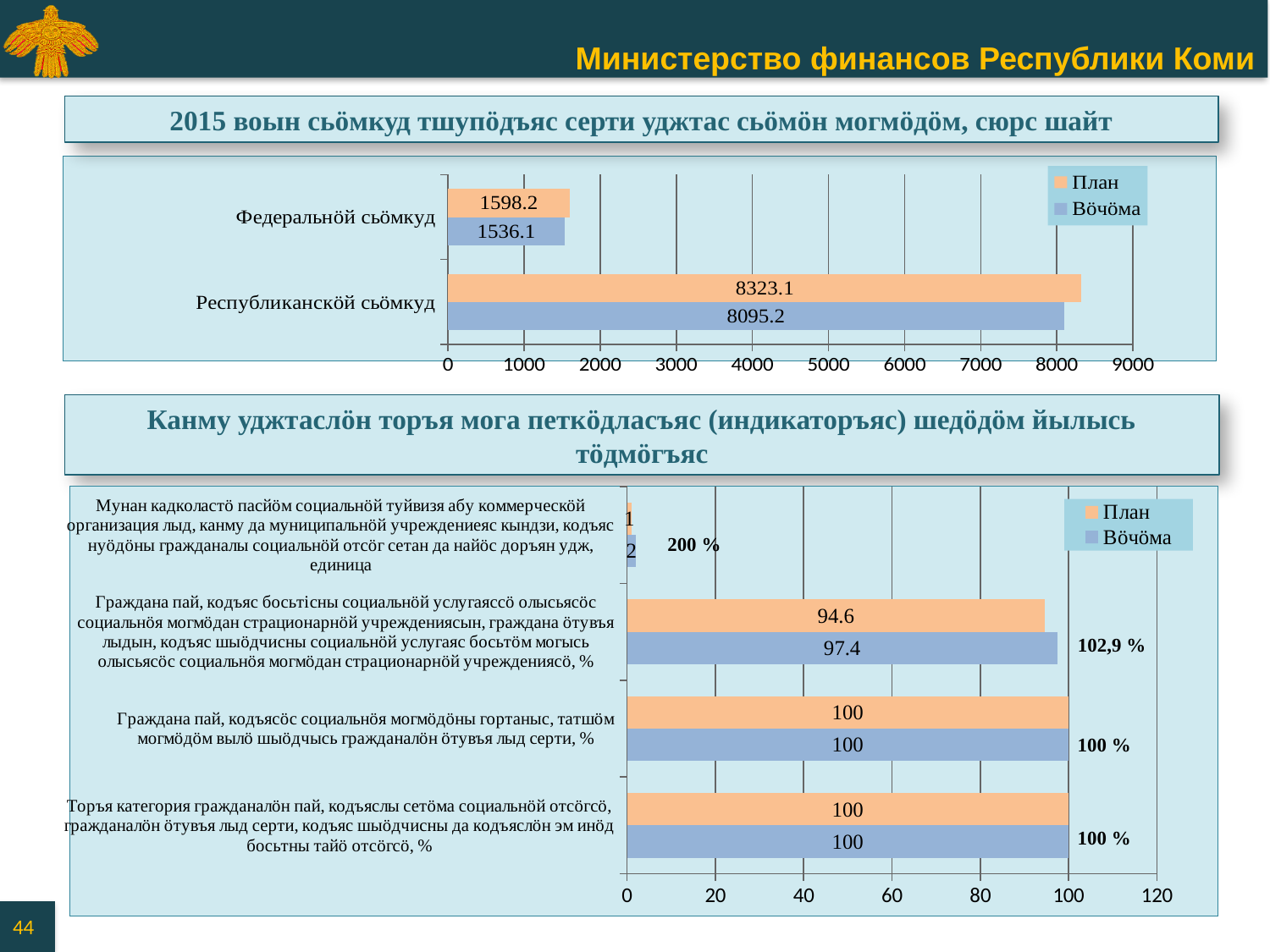
In the bottom chart, what percentage is printed next to the bars for the first (top) category? 200 % In the top chart, what is the difference between the План and Вöчöма values for Республиканскöй сьöмкуд? 227.9 How many categories are shown in the bottom chart? 4 In the bottom chart, for the category about citizens receiving social services in stationary institutions, which is larger: the План value or the Вöчöма value? Вöчöма In the bottom chart, what is the План value for the category about citizens receiving social services in stationary institutions (Граждана пай, кодъяс босьтісны социальнöй услугаяссö...)? 94.6 What kind of chart is the top chart? bar chart In the bottom chart, what is the Вöчöма value for the category about citizens receiving social services in stationary institutions (Граждана пай, кодъяс босьтісны социальнöй услугаяссö...)? 97.4 In the top chart, which category has the higher План value? Республиканскöй сьöмкуд In the top chart, is the Вöчöма value for Федеральнöй сьöмкуд greater or less than 2000? less In the top chart, what is the Вöчöма value for Республиканскöй сьöмкуд? 8095.2 In the top chart, how many series does the legend list? 2 In the top chart, what is the План value for Федеральнöй сьöмкуд? 1598.2